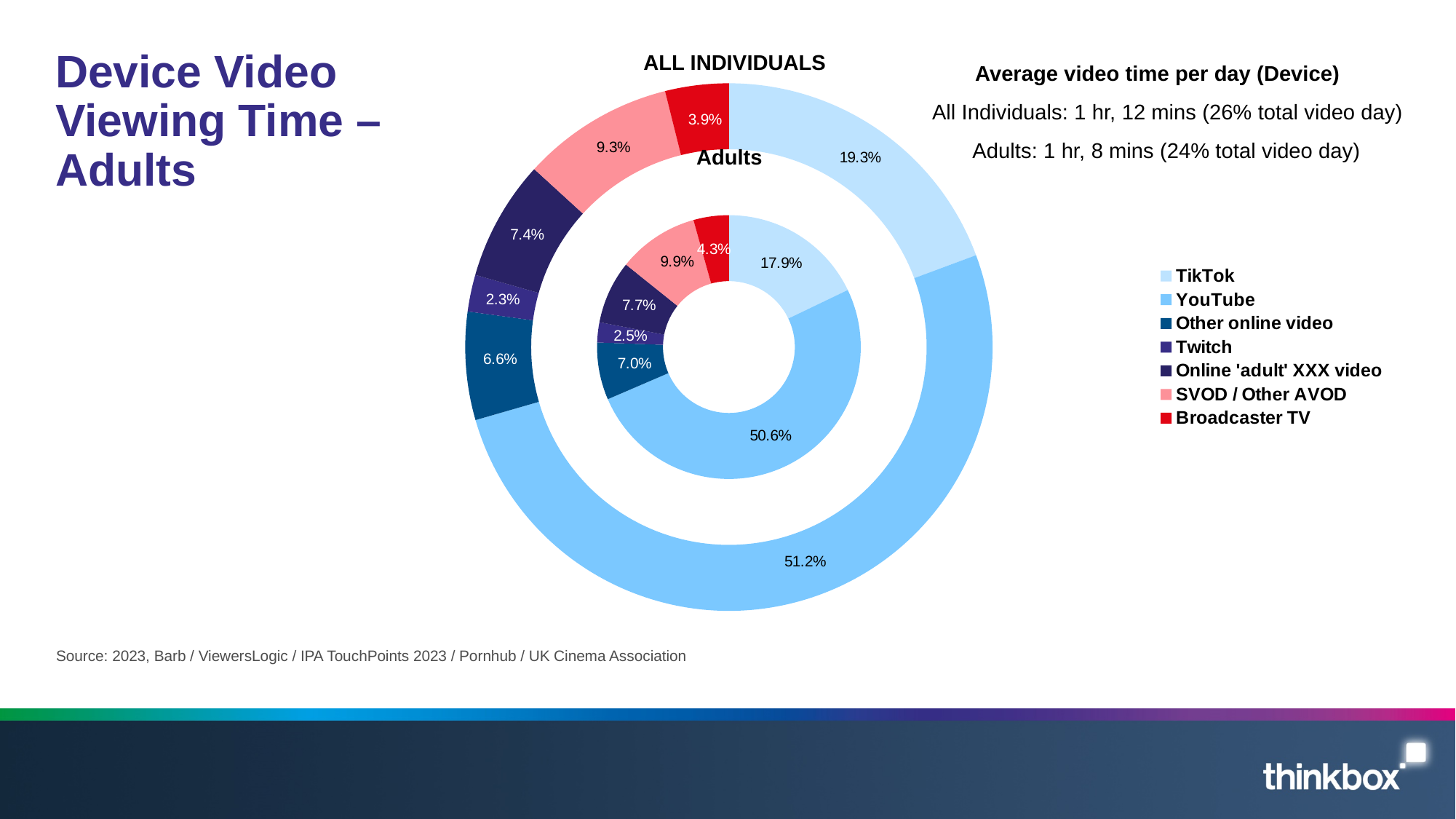
In the outer ring (All Individuals), what share is SVOD / Other AVOD? 9.3% Is the Broadcaster TV share larger for All Individuals or for Adults? Adults What kind of chart is shown on the slide? Doughnut chart In the inner ring (Adults), what share is Broadcaster TV? 4.3% In the outer ring (All Individuals), what share of device video viewing time is YouTube? 51.2% Which category has the smallest share in the Adults ring? Twitch According to the text on the slide, what is the average device video time per day for Adults? 1 hr, 8 mins (24% total video day) Which category has the largest share in the All Individuals ring? YouTube How many categories does the legend list? 7 What is the difference between the TikTok share for All Individuals and for Adults? 1.4 percentage points In the inner ring (Adults), what share of device video viewing time is TikTok? 17.9% In the Adults ring, what is the difference between the Online 'adult' XXX video share and the Twitch share? 5.2 percentage points